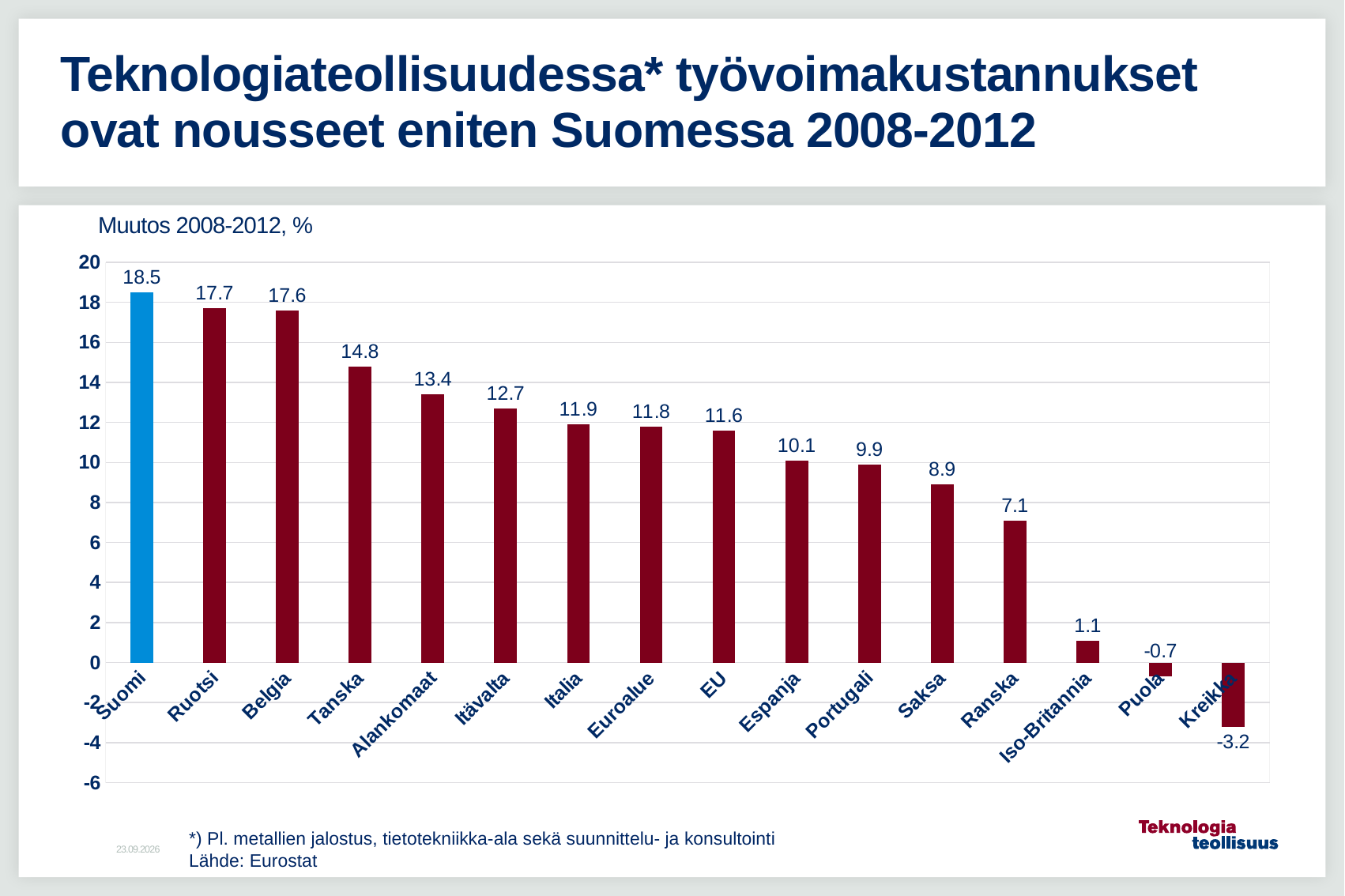
How many categories are shown on the x axis? 16 What is the difference between the values for Suomi and Ruotsi? 0.8 What is the value shown for Saksa? 8.9 Do the values generally rise or fall from left to right along the x axis? Fall What is the difference between the values for Tanska and Ranska? 7.7 What is the value shown for Kreikka? -3.2 What is the value shown for Suomi? 18.5 Which category has the lowest value? Kreikka Which category has the highest value? Suomi What is the label shown above the chart describing the plotted measure? Muutos 2008-2012, % Which is larger, the value for Espanja or the value for Saksa? Espanja What kind of chart is shown on the slide? Bar chart